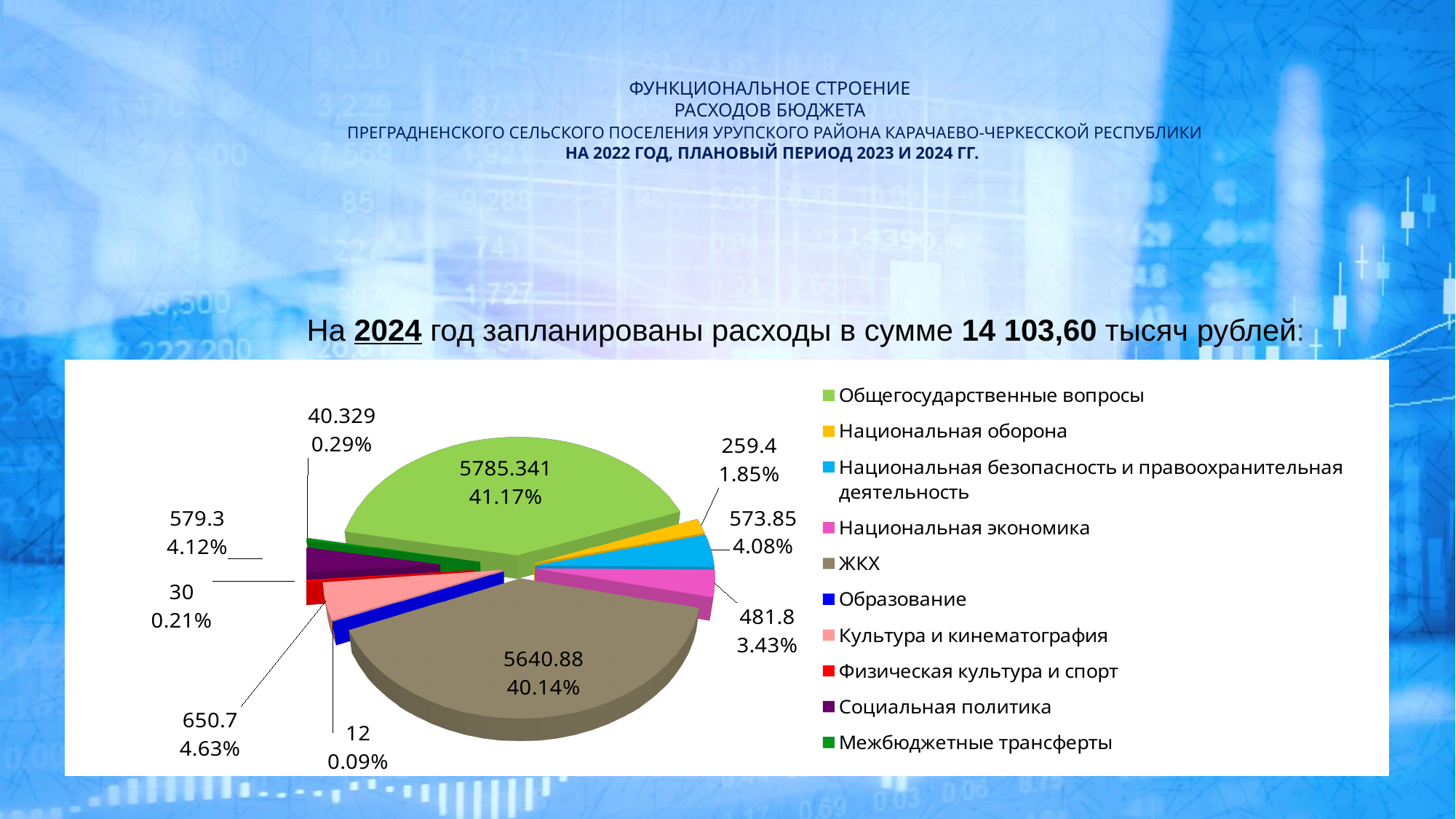
How many categories does the legend list? 10 Which is larger, Национальная безопасность и правоохранительная деятельность or Национальная экономика? Национальная безопасность и правоохранительная деятельность Which category has the largest slice of the pie? Общегосударственные вопросы What is the value for ЖКХ? 5640.88 What is the difference between the values for Физическая культура и спорт and Образование? 18 What share of the pie does Межбюджетные трансферты represent? 0.29% What is the value for Культура и кинематография? 650.7 What is the value for Национальная оборона? 259.4 What is the value for Общегосударственные вопросы? 5785.341 What kind of chart is shown on the slide? pie chart Which category has the smallest slice of the pie? Образование What share of the pie does Социальная политика represent? 4.12%